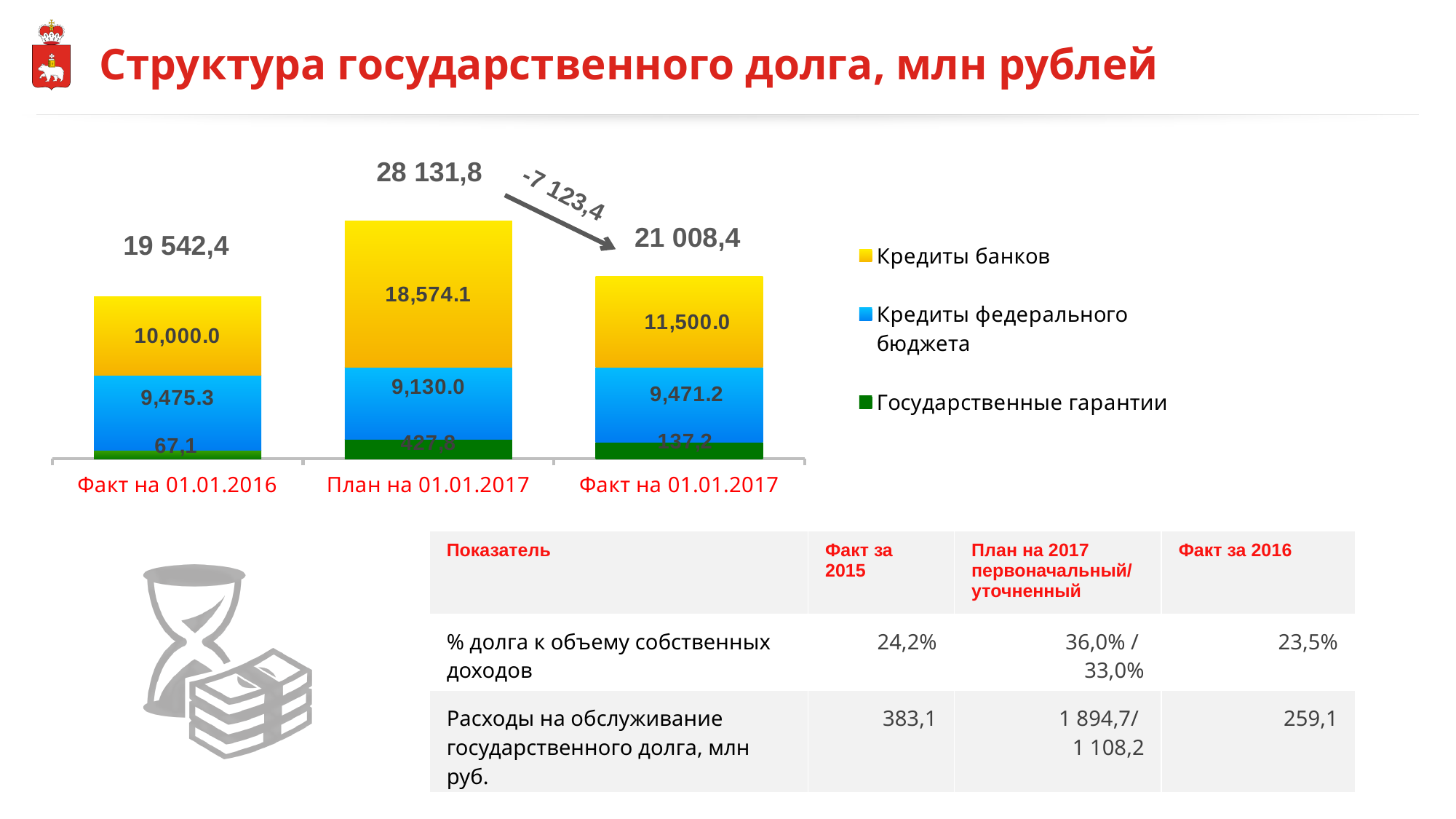
Which is larger: Кредиты банков for Факт на 01.01.2017 or Кредиты банков for Факт на 01.01.2016? Факт на 01.01.2017 How many categories are shown on the x axis of the chart? 3 Which category has the lowest value for Государственные гарантии? Факт на 01.01.2016 Which category has the highest total government debt? План на 01.01.2017 What is the total of the stacked bar for Факт на 01.01.2016? 19 542,4 What is the value of Государственные гарантии for Факт на 01.01.2017? 137,2 What change between План на 01.01.2017 and Факт на 01.01.2017 is shown by the arrow on the chart? -7 123,4 What type of chart is shown on the slide? stacked bar chart What is the total of the stacked bar for План на 01.01.2017? 28 131,8 How many series does the chart legend list? 3 What is the value of Кредиты федерального бюджета for Факт на 01.01.2016? 9,475.3 What is the value of Кредиты банков for План на 01.01.2017? 18,574.1